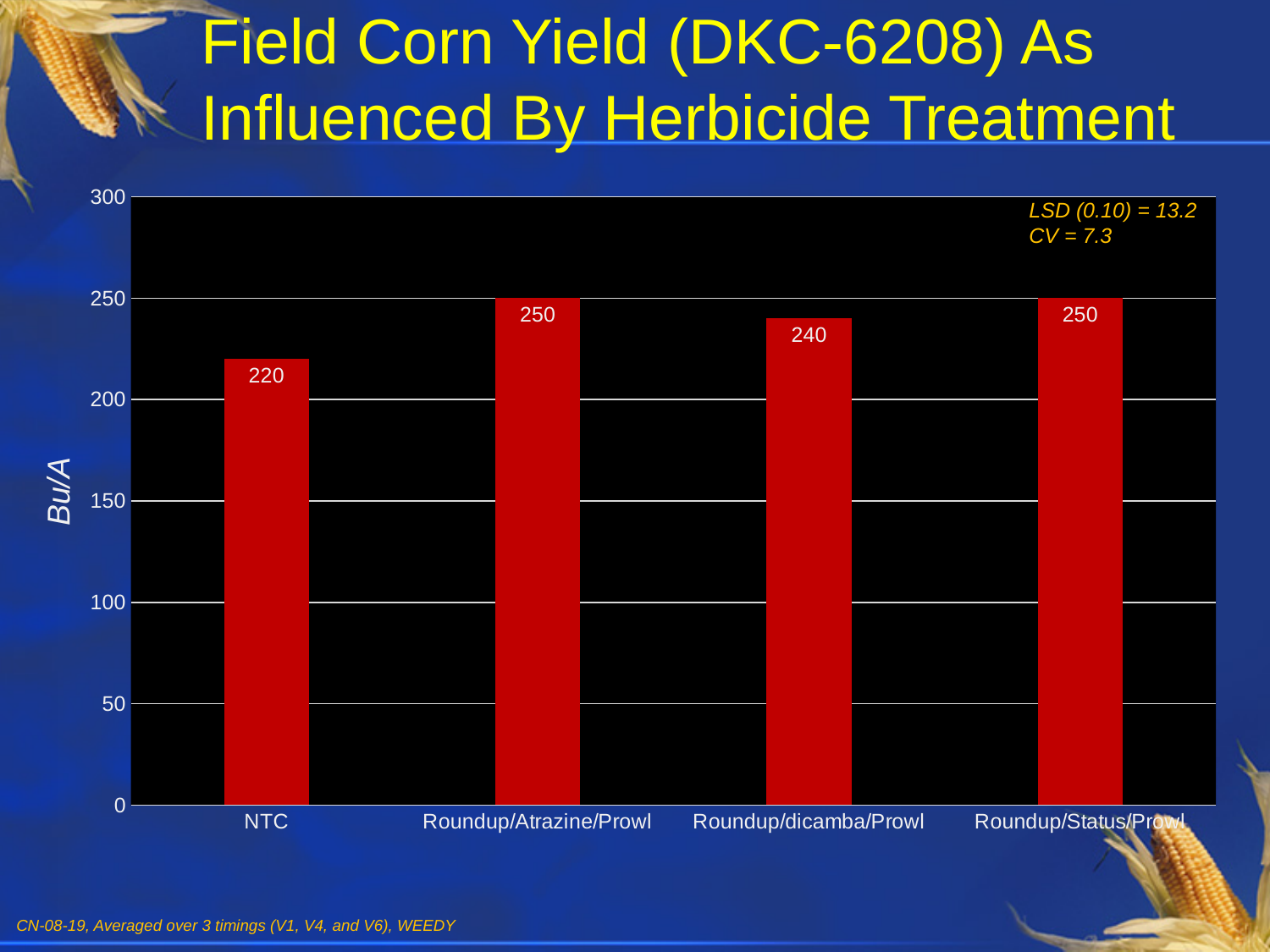
What is the LSD (0.10) value shown on the chart? 13.2 What is the yield value for Roundup/dicamba/Prowl? 240 Which has a higher yield, NTC or Roundup/dicamba/Prowl? Roundup/dicamba/Prowl What is the yield value for NTC? 220 What is the yield value for Roundup/Atrazine/Prowl? 250 What is the difference in yield between Roundup/Atrazine/Prowl and NTC? 30 What is the difference in yield between Roundup/Status/Prowl and Roundup/dicamba/Prowl? 10 What is the label on the y axis? Bu/A Is the value for NTC greater or less than 200? greater What kind of chart is shown on the slide? bar chart Which treatment has the lowest yield? NTC How many treatments are shown on the chart? 4